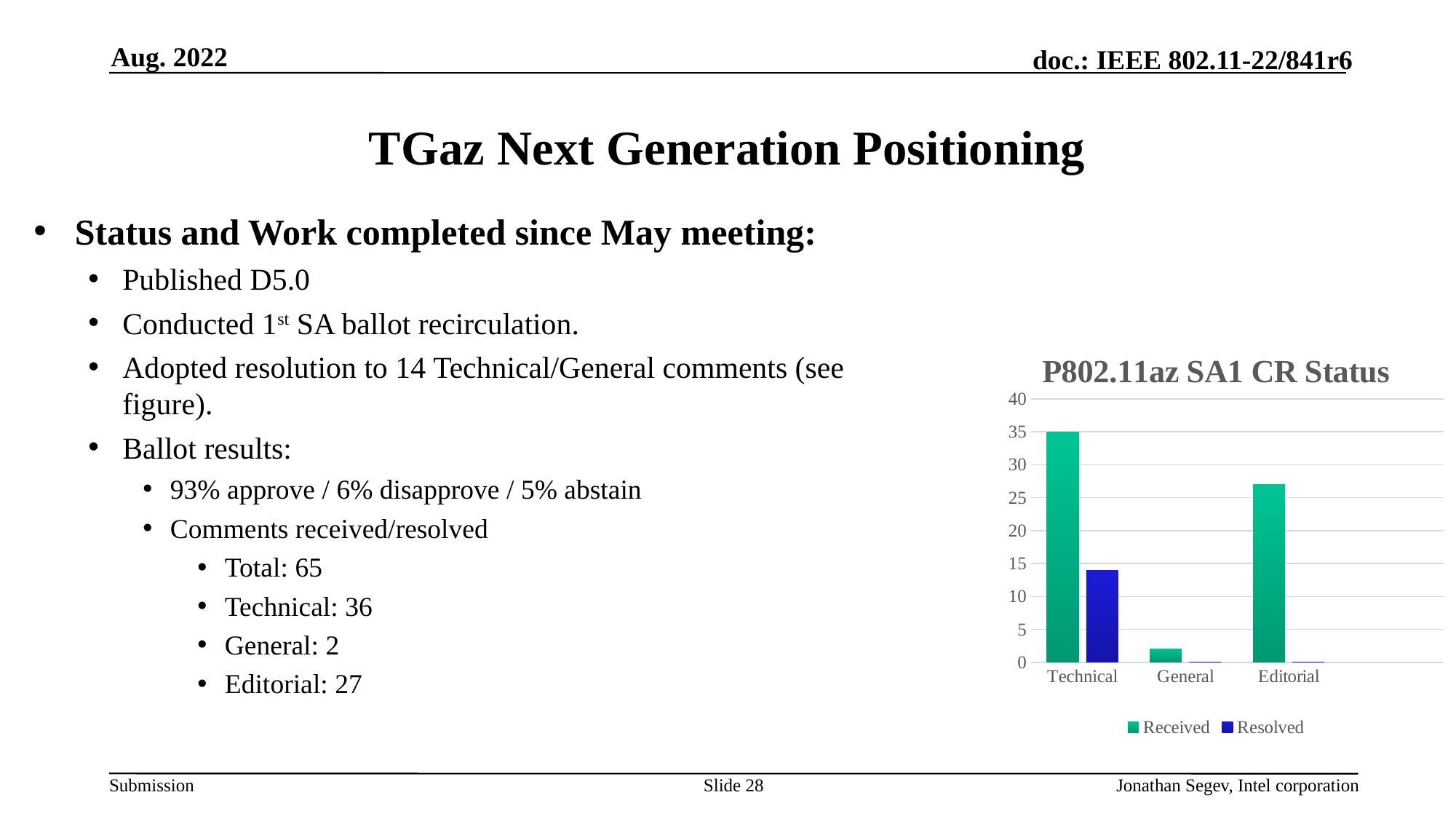
Which category has the lowest Received value? General What is the title of the chart? P802.11az SA1 CR Status Which category has the highest Received value? Technical Which is larger for Technical, the Received value or the Resolved value? Received Is the Received value for Editorial greater or less than 25? greater How many categories are shown on the x axis of the chart? 3 Is the Received value for Technical greater or less than 30? greater What kind of chart is shown on the slide? bar chart Is the Received value for General greater or less than 5? less Which series is shown in blue in the chart? Resolved How many series does the chart legend list? 2